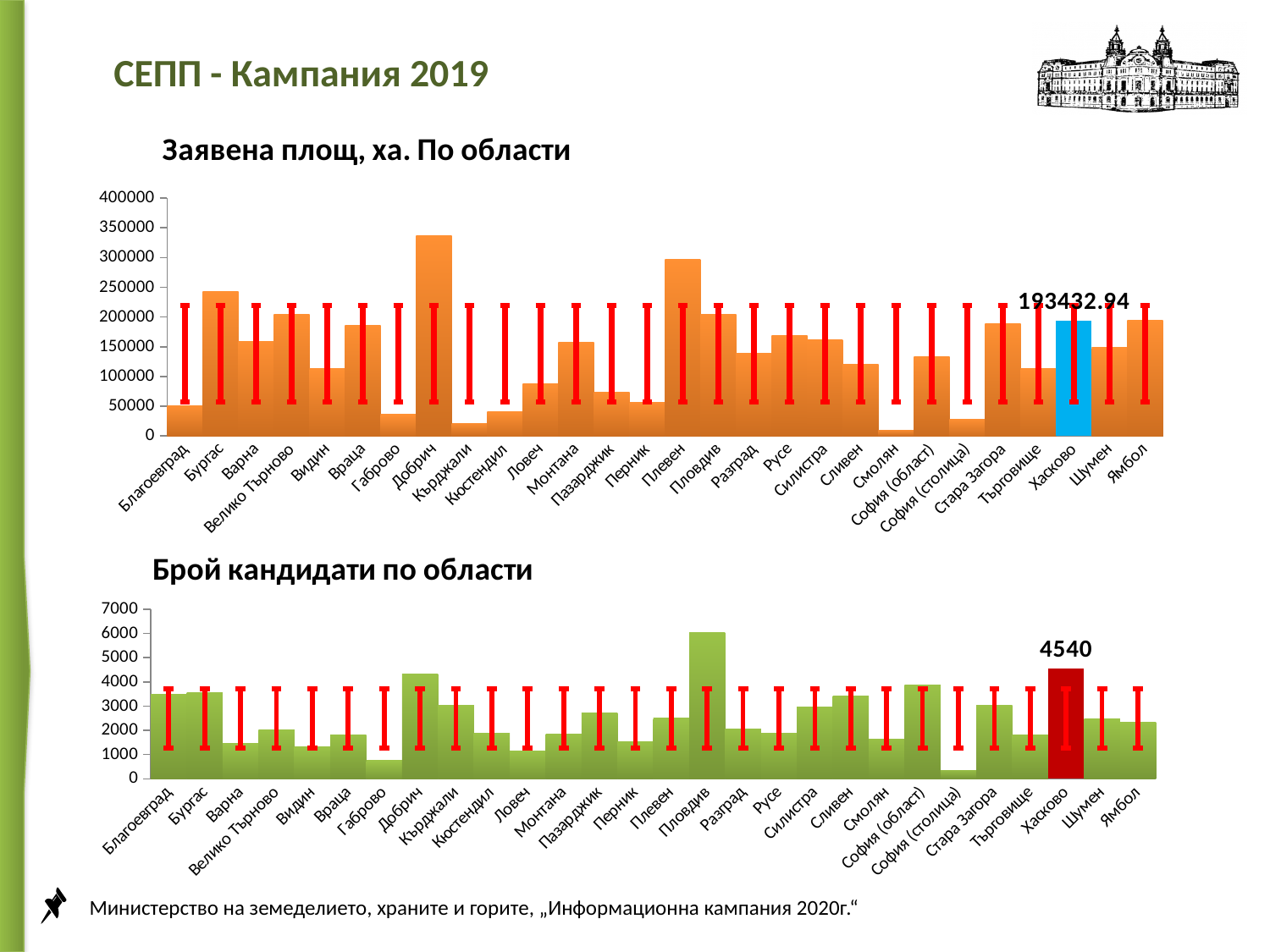
How many regions are shown on the chart 'Брой кандидати по области'? 28 On the chart 'Брой кандидати по области', which region has the lowest value? София (столица) On the chart 'Заявена площ, ха. По области', which region has the highest value? Добрич On the chart 'Брой кандидати по области', is the value for Пловдив greater or less than 5000? greater What kind of chart is 'Заявена площ, ха. По области'? bar chart On the chart 'Брой кандидати по области', which region has the highest value? Пловдив On the chart 'Заявена площ, ха. По области', which is larger, the value for Добрич or the value for Плевен? Добрич On the chart 'Заявена площ, ха. По области', which region has the lowest value? Смолян On the chart 'Заявена площ, ха. По области', is the value for Добрич greater or less than 300000? greater On the chart 'Брой кандидати по области', what is the value for Хасково? 4540 On the chart 'Брой кандидати по области', is the value for Габрово greater or less than 1000? less On the chart 'Заявена площ, ха. По области', what is the value for Хасково? 193432.94